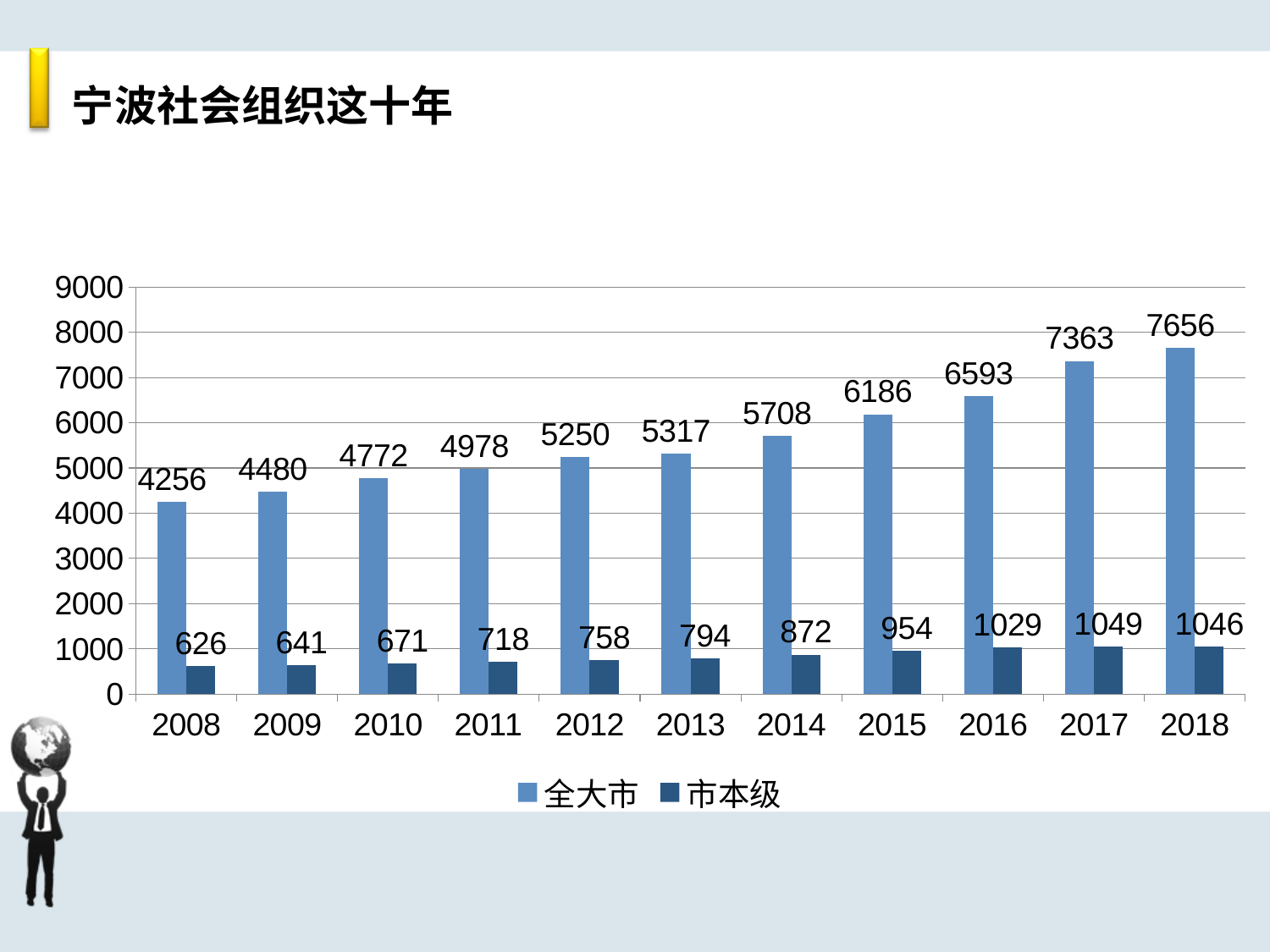
How many years are shown on the x axis? 11 Do the 全大市 values rise or fall from 2008 to 2018? rise What is the value for 市本级 in 2015? 954 How many series does the legend list? 2 Which year has the highest value for 全大市? 2018 What is the value for 全大市 in 2018? 7656 What kind of chart is shown on the slide? bar chart Which year has the lowest value for 市本级? 2008 Which is larger, the 市本级 value for 2017 or for 2018? 2017 Which year has the highest value for 市本级? 2017 What is the value for 全大市 in 2008? 4256 What is the difference between the 全大市 values for 2018 and 2008? 3400